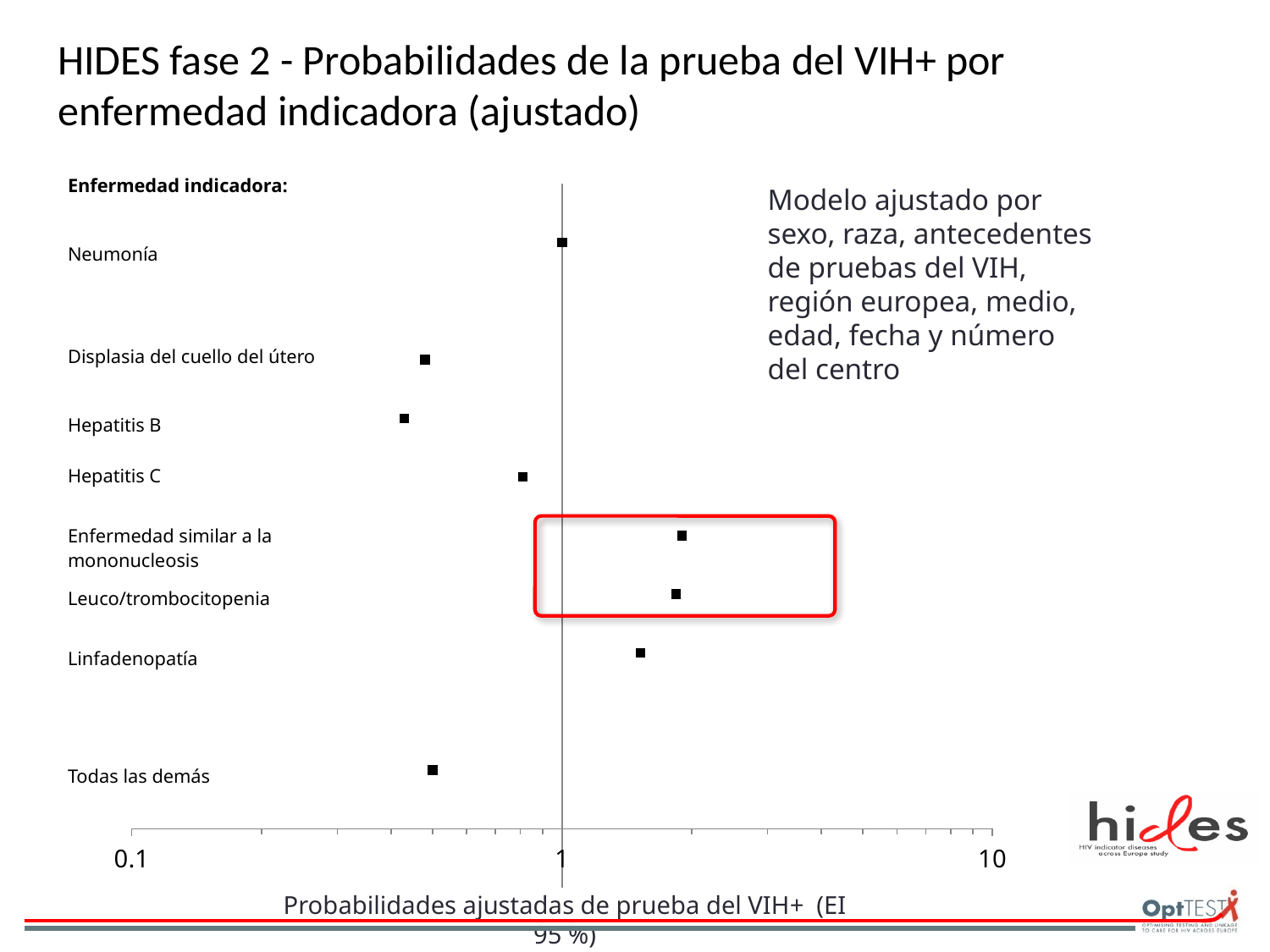
What kind of chart is shown on the slide? Scatter (dot) plot Is the value for Linfadenopatía greater or less than 1? greater Is the value for Enfermedad similar a la mononucleosis greater or less than 1? greater Which has the larger value, Linfadenopatía or Displasia del cuello del útero? Linfadenopatía Which has the larger value, Hepatitis B or Hepatitis C? Hepatitis C Is the value for Todas las demás greater or less than 1? less What are the minimum and maximum values shown on the x axis? 0.1 and 10 How many indicator diseases (categories) are plotted on the chart? 8 What is the title of the x axis of the chart? Probabilidades ajustadas de prueba del VIH+ (EI 95 %)